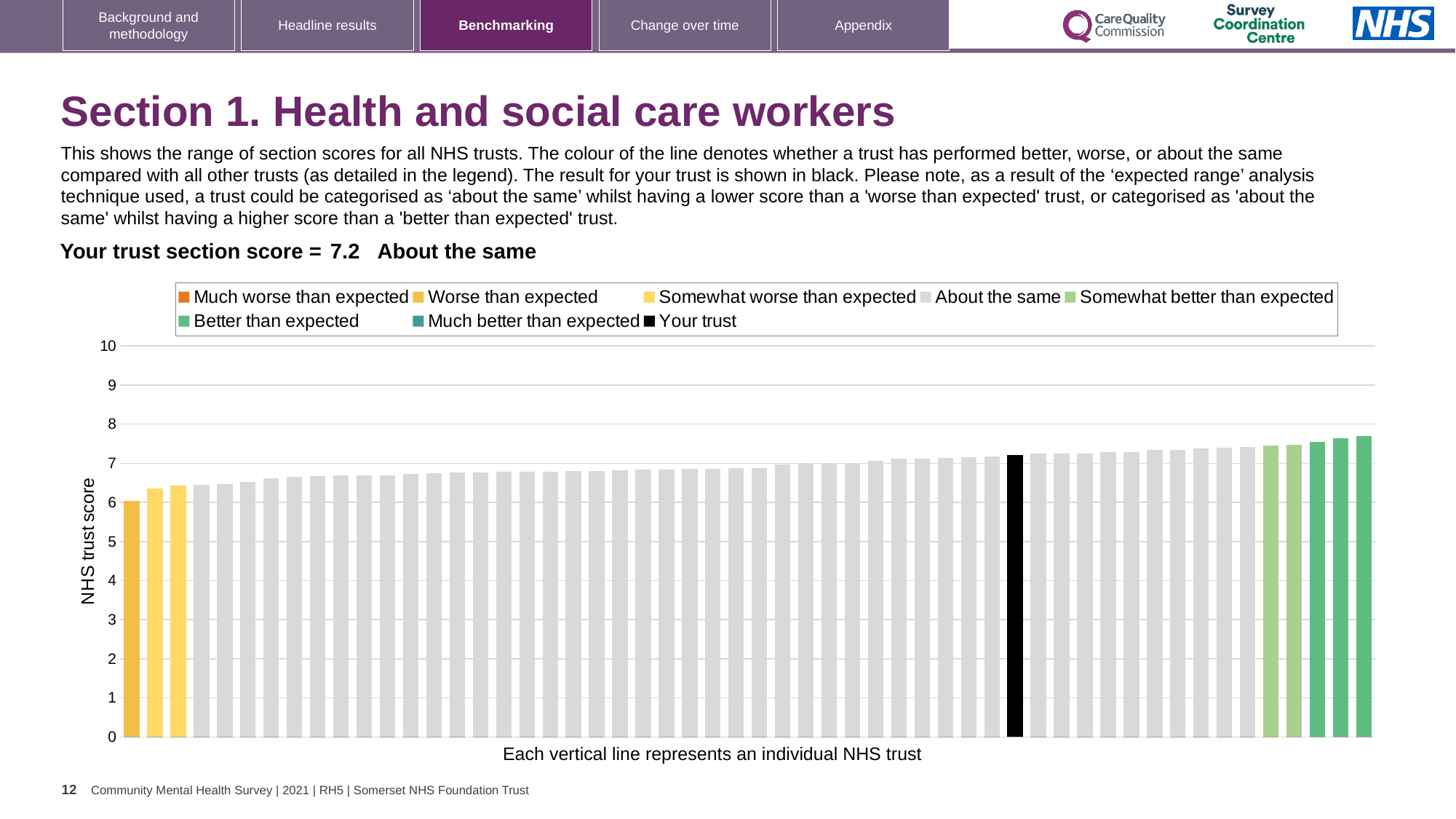
Which is larger: the black 'Your trust' bar or the leftmost yellow bar? the black 'Your trust' bar Is the value of the leftmost (lowest) bar greater or less than 5? greater How many entries does the chart legend list? 8 How many bars are coloured as 'Better than expected' (dark green)? 3 What kind of chart is shown on the slide? bar chart Is the value of the rightmost (highest) bar greater or less than 8? less What is the section score for your trust shown on the slide? 7.2 What is the label on the vertical axis of the chart? NHS trust score According to the chart, what does each vertical line represent? an individual NHS trust How many bars are coloured as 'Somewhat worse than expected' (yellow)? 2 Is the value of the black 'Your trust' bar greater or less than 7? greater Do the bar values rise or fall from left to right along the x axis? rise